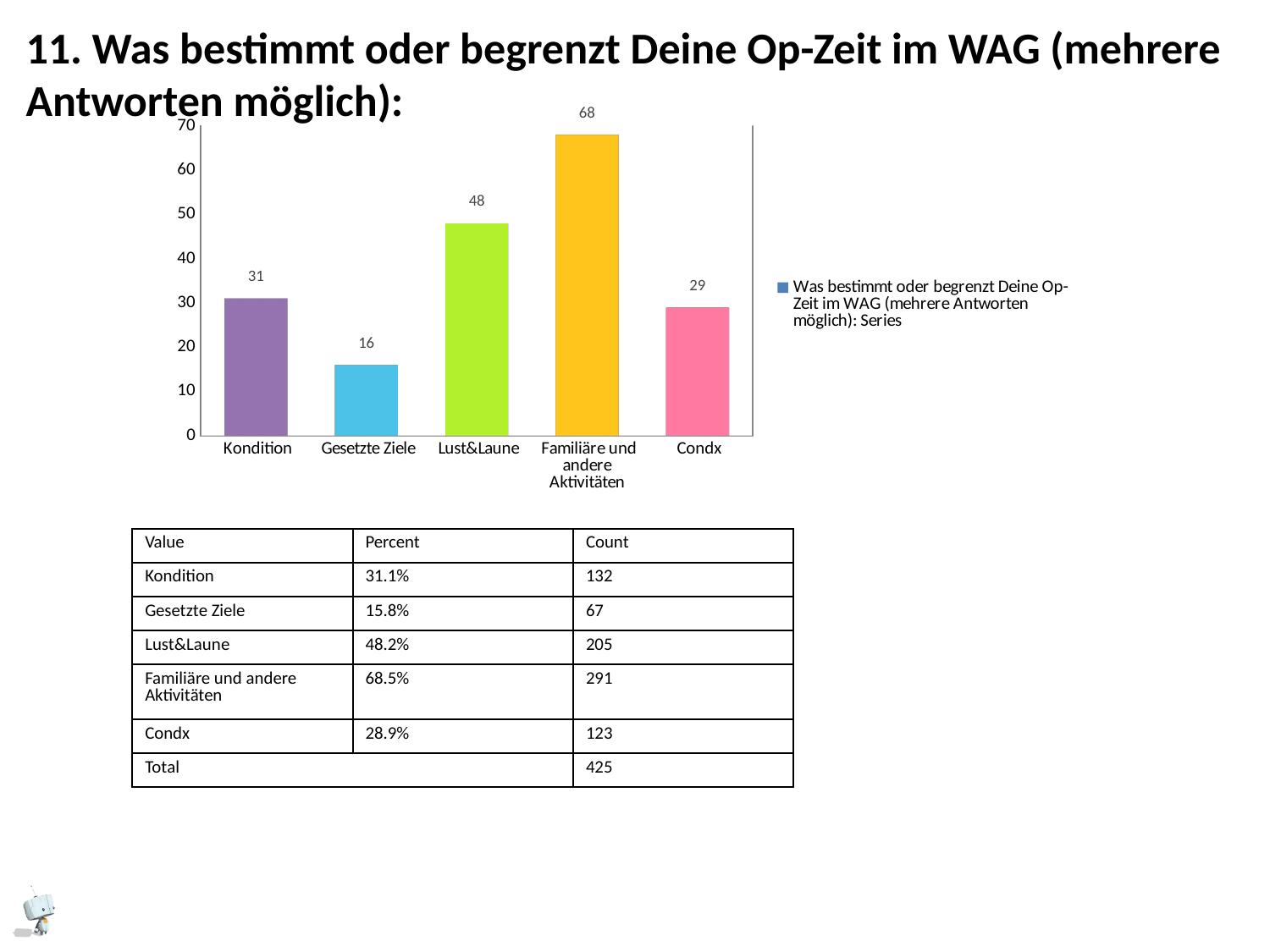
What is the value for Condx? 29 What is the difference between the values for Familiäre und andere Aktivitäten and Lust&Laune? 20 What is the value for Gesetzte Ziele? 16 How many series does the legend list? 1 What is the value for Lust&Laune? 48 How many categories are shown on the x axis? 5 Which is larger, the value for Kondition or the value for Condx? Kondition What is the value for Kondition? 31 What kind of chart is shown on the slide? bar chart What is the value for Familiäre und andere Aktivitäten? 68 Which category has the lowest value? Gesetzte Ziele Which category has the highest value? Familiäre und andere Aktivitäten